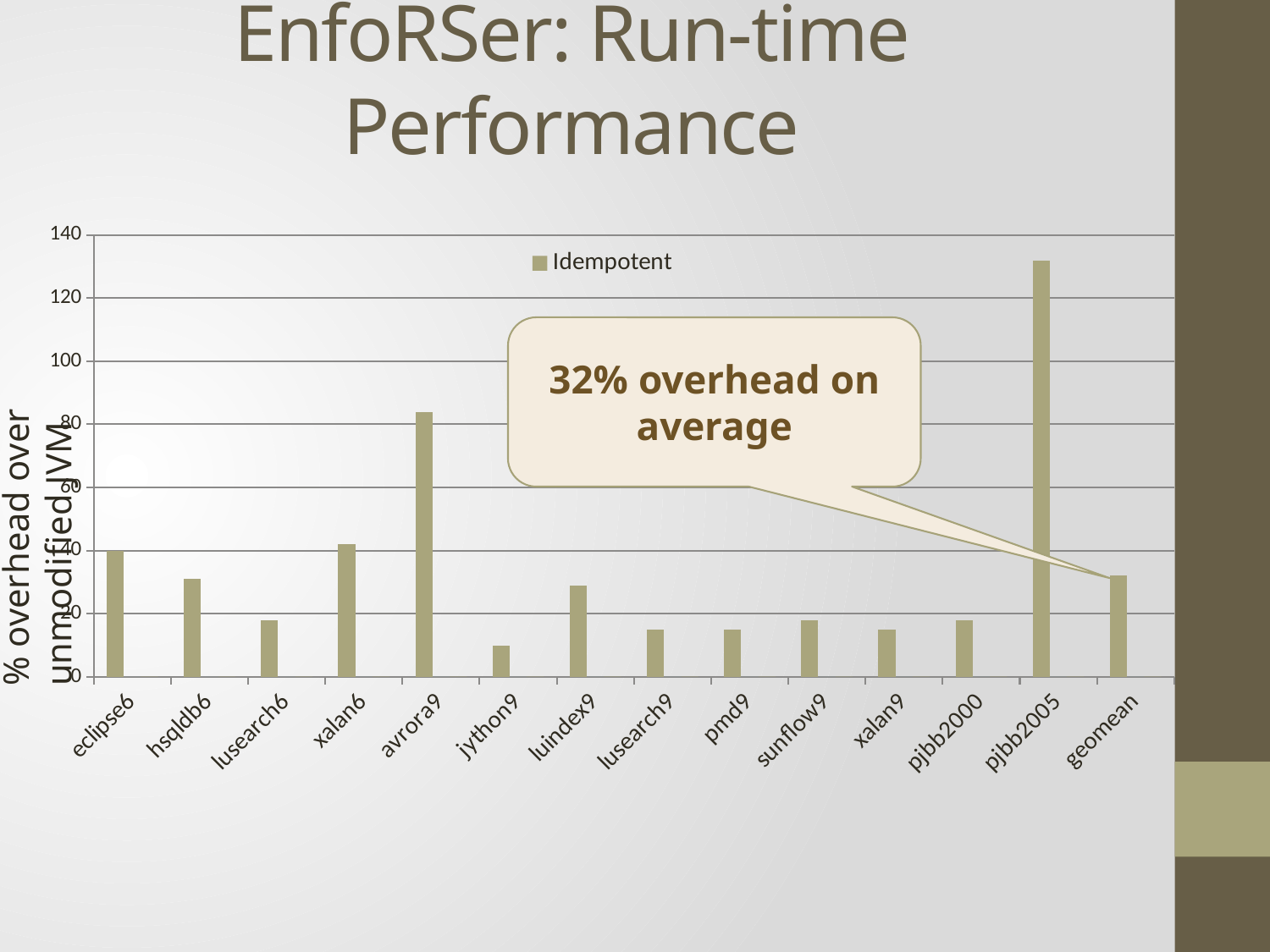
What is the name of the series in the legend? Idempotent Which benchmark has the lowest overhead? jython9 Is the value for avrora9 greater or less than 60? greater According to the callout, what is the average overhead (geomean)? 32% How many series does the legend list? 1 Is the value for jython9 greater or less than 20? less Is the value for pjbb2005 greater or less than 120? greater How many benchmark categories are shown on the x axis? 14 Which has a larger overhead, avrora9 or xalan6? avrora9 Which benchmark has the highest overhead? pjbb2005 Which has a larger overhead, eclipse6 or lusearch6? eclipse6 What kind of chart is shown on the slide? bar chart